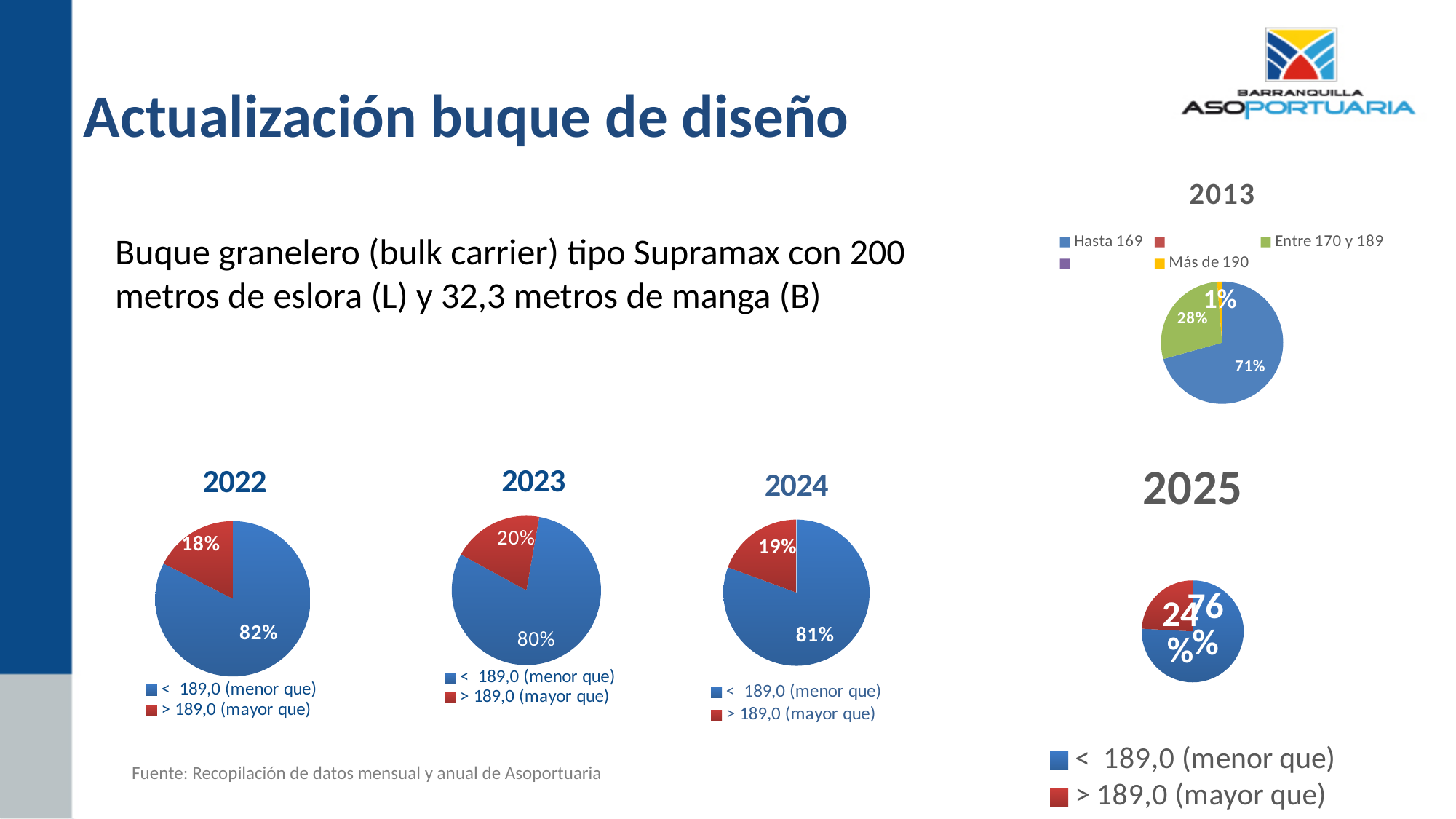
In the 2023 pie chart, what share is labelled for the '> 189,0 (mayor que)' slice? 20% In the 2022 pie chart, what share is labelled for the '< 189,0 (menor que)' slice? 82% In the 2024 pie chart, what is the difference between the '< 189,0 (menor que)' and '> 189,0 (mayor que)' shares? 62% Which is larger: the '> 189,0 (mayor que)' share in 2023 or in 2022? 2023 What kind of chart is used for the 2022 data? Pie chart In the 2022 pie chart, what share is labelled for the '> 189,0 (mayor que)' slice? 18% In the 2013 pie chart, which category has the smallest slice? Más de 190 In the 2013 pie chart, what share is labelled for 'Entre 170 y 189'? 28% How many entries does the legend of the 2024 chart list? 2 In the 2024 pie chart, what share is labelled for the '< 189,0 (menor que)' slice? 81% In the 2023 pie chart, which colour represents the '< 189,0 (menor que)' category? Blue In the 2013 pie chart, what share is labelled for 'Hasta 169'? 71%